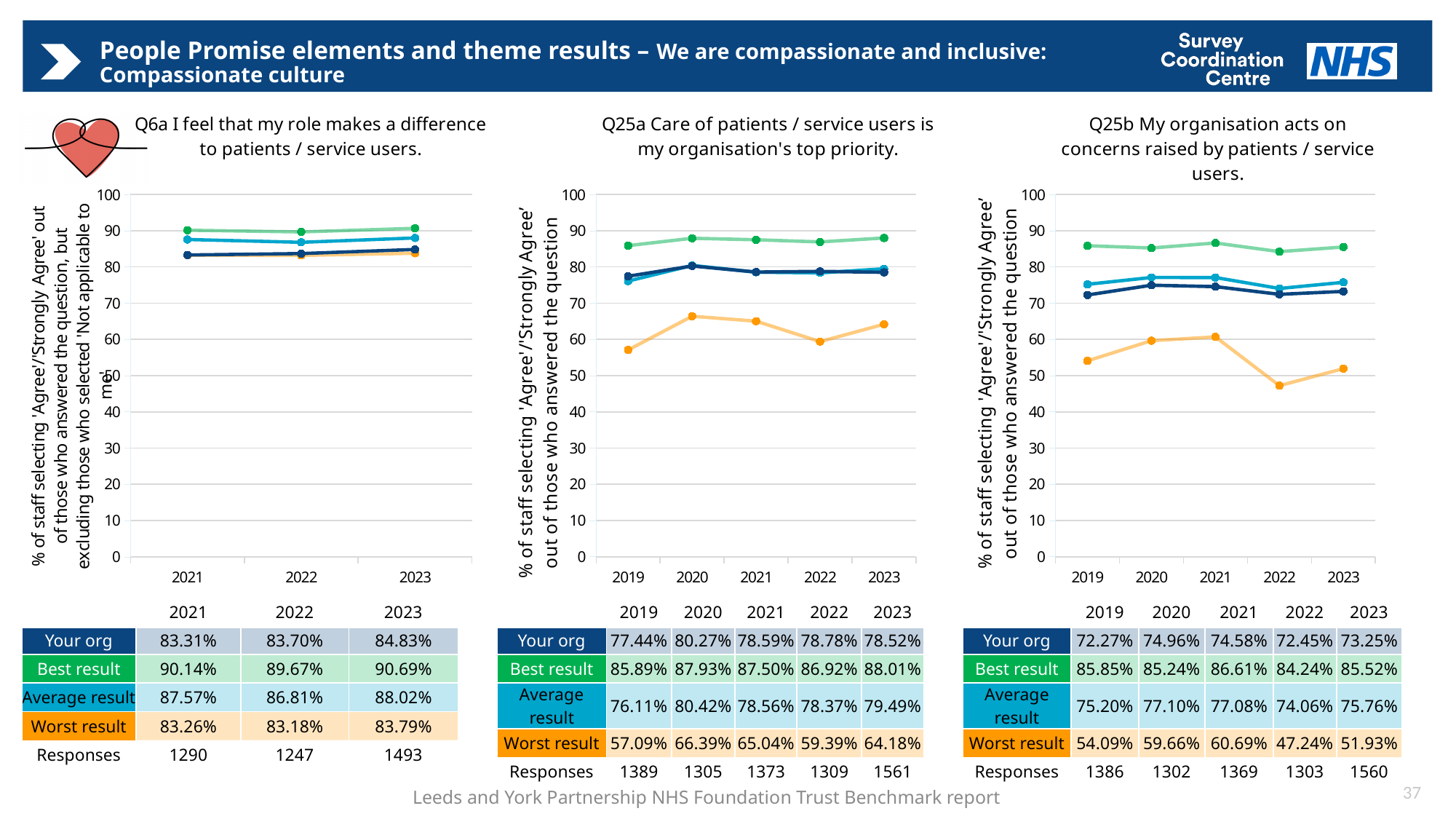
In the Q25b chart, what is the Best result value for 2021? 86.61% In the Q6a chart, how many series are plotted? 4 In the Q25b chart, is the Your org value higher in 2020 or in 2023? 2020 In the Q6a chart, what is the difference between the Best result and Your org values in 2023? 5.86 percentage points In the Q25a chart, what is the Worst result value for 2022? 59.39% In the Q6a chart, what is the Your org value for 2023? 84.83% In the Q25a chart, how many years are plotted on the x axis? 5 What type of chart is used for Q25b? Line chart In the Q25a chart, which year has the highest Your org value? 2020 In the Q6a chart, does the Your org value rise or fall from 2021 to 2023? Rises In the Q25a chart, is the Worst result value for 2019 greater or less than 60? less In the Q25b chart, which year has the lowest Worst result value? 2022